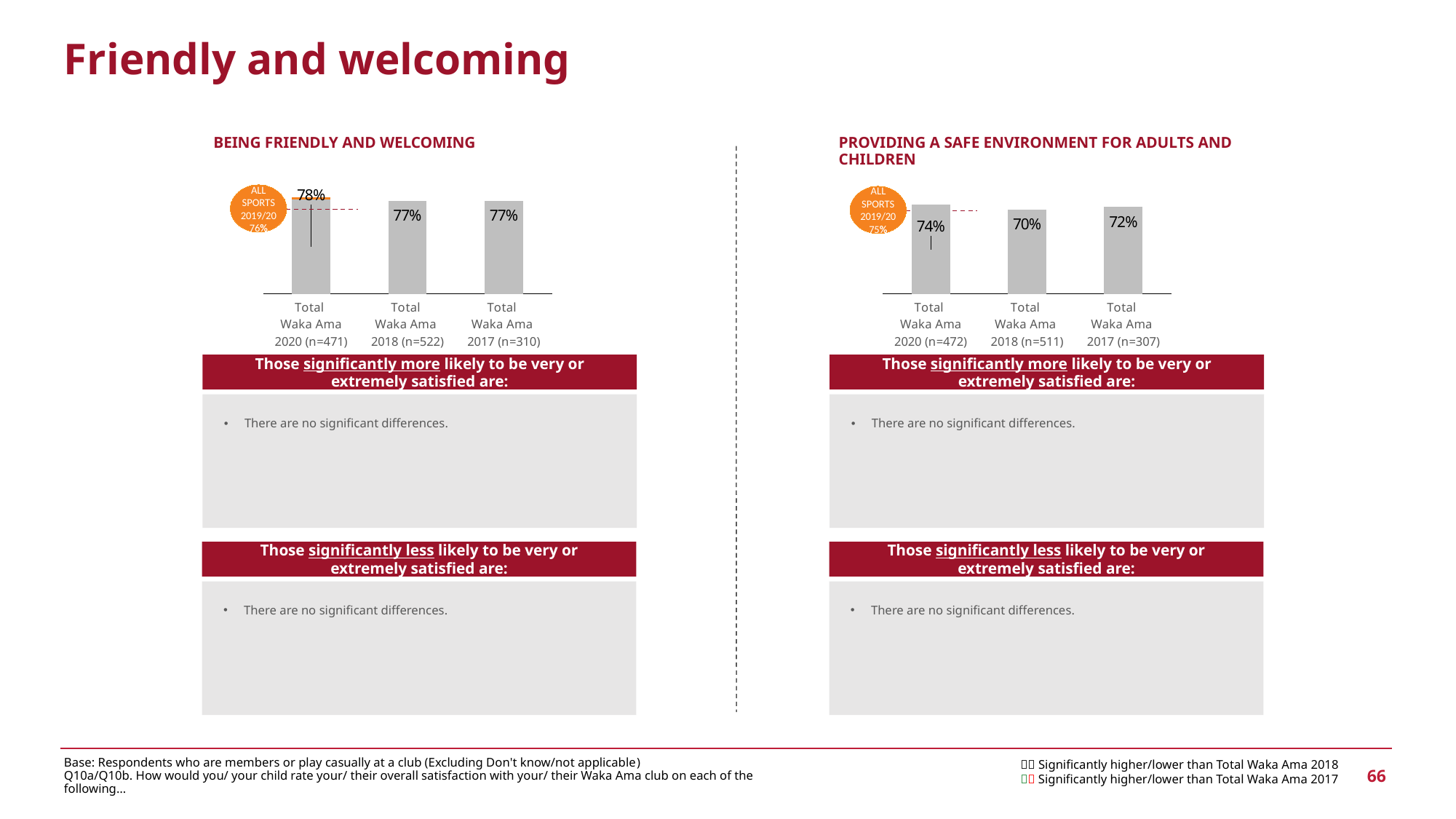
In the 'Providing a safe environment for adults and children' chart, what is the value for Total Waka Ama 2017 (n=307)? 72% In the 'Providing a safe environment for adults and children' chart, what is the value for Total Waka Ama 2020 (n=472)? 74% In the 'Being friendly and welcoming' chart, what is the value for Total Waka Ama 2018 (n=522)? 77% In the 'Providing a safe environment for adults and children' chart, what is the difference between the 2020 and 2018 values? 4 percentage points What type of chart is used for 'Providing a safe environment for adults and children'? Bar chart How many bars are in the 'Being friendly and welcoming' chart? 3 In the 'Providing a safe environment for adults and children' chart, what is the value for Total Waka Ama 2018 (n=511)? 70% In the 'Being friendly and welcoming' chart, what is the All Sports 2019/20 benchmark value shown in the orange circle? 76% In the 'Providing a safe environment for adults and children' chart, which category has the lowest value? Total Waka Ama 2018 (n=511) In the 'Being friendly and welcoming' chart, what is the value for Total Waka Ama 2020 (n=471)? 78% In the 'Providing a safe environment for adults and children' chart, which category has the highest value? Total Waka Ama 2020 (n=472) In the 'Being friendly and welcoming' chart, what is the difference between the 2020 and 2017 values? 1 percentage point